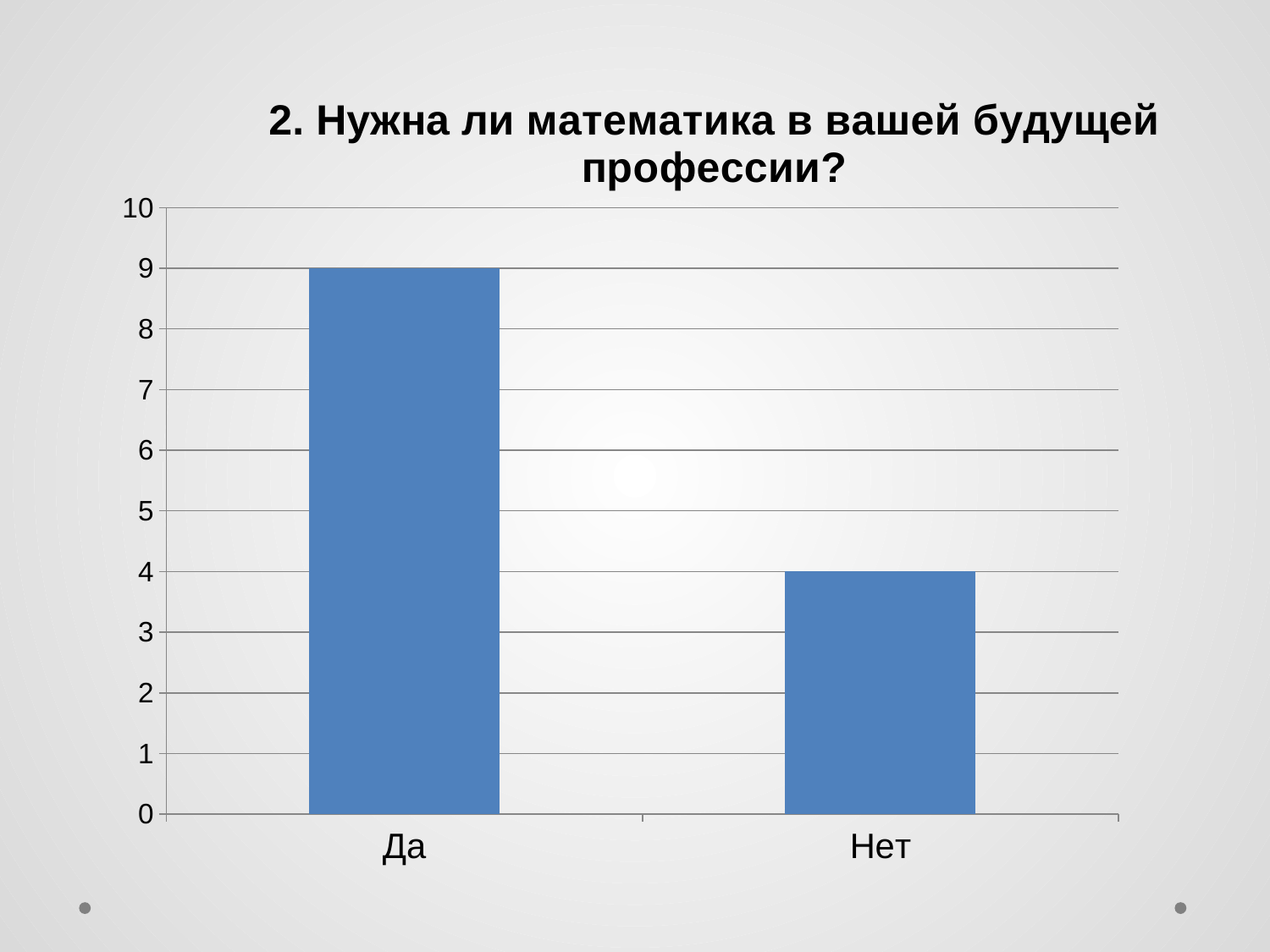
What is the maximum value shown on the vertical axis? 10 How many categories are shown on the x axis? 2 Which is larger, the value for Да or the value for Нет? Да What is the title of the chart? 2. Нужна ли математика в вашей будущей профессии? What kind of chart is shown on the slide? bar chart Which category has the lowest value? Нет What is the difference between the values for Да and Нет? 5 What is the value for Нет? 4 Is the value for Да greater or less than 8? greater Which category has the highest value? Да What is the value for Да? 9 Is the value for Нет greater or less than 5? less